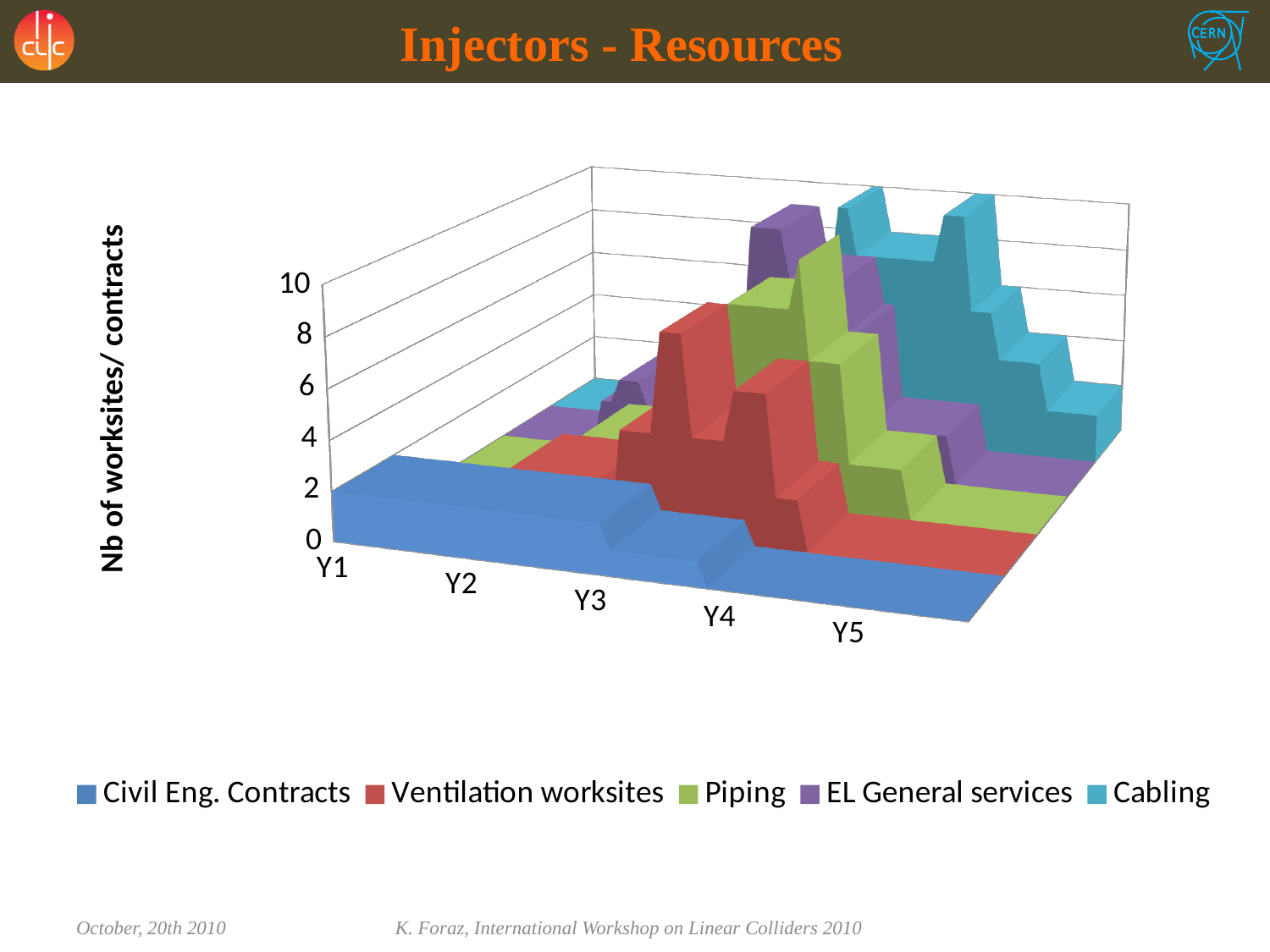
What is the label of the vertical axis? Nb of worksites/ contracts What is the first category on the x axis? Y1 How many series does the legend list? 5 What is the last category on the x axis? Y5 What kind of chart is shown on the slide? 3D area chart Is the value for Civil Eng. Contracts at Y1 greater or less than 6? less How many categories are shown along the x axis? 5